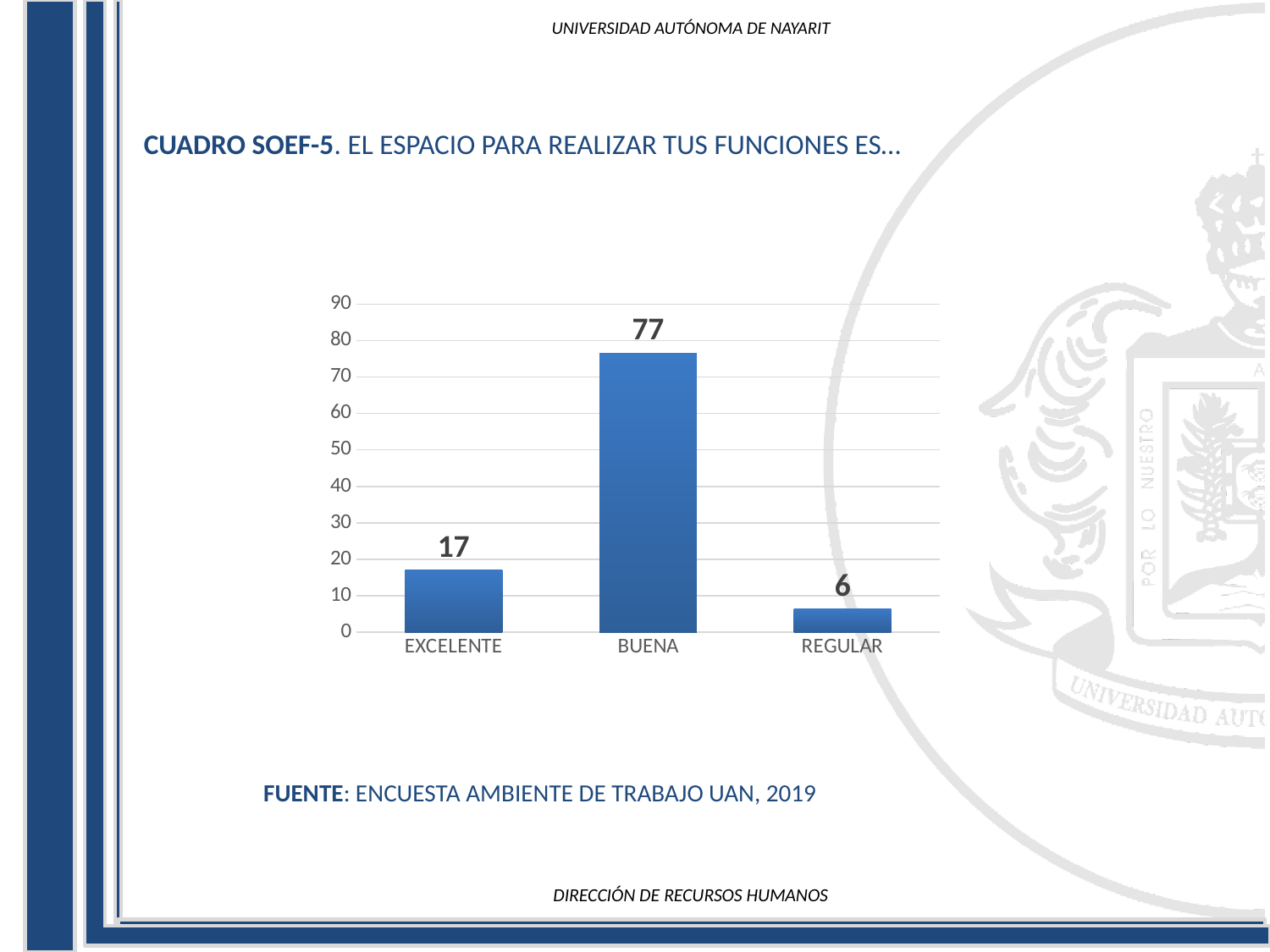
What is the difference between the values for BUENA and EXCELENTE? 60 What is the source cited below the chart? ENCUESTA AMBIENTE DE TRABAJO UAN, 2019 What is the value for EXCELENTE? 17 What is the value for BUENA? 77 Which is larger, the value for EXCELENTE or the value for REGULAR? EXCELENTE What kind of chart is shown on the slide? bar chart What is the value for REGULAR? 6 How many categories are shown on the x axis? 3 What is the difference between the values for EXCELENTE and REGULAR? 11 Which category has the lowest value? REGULAR Which category has the highest value? BUENA Is the value for BUENA greater or less than 70? greater